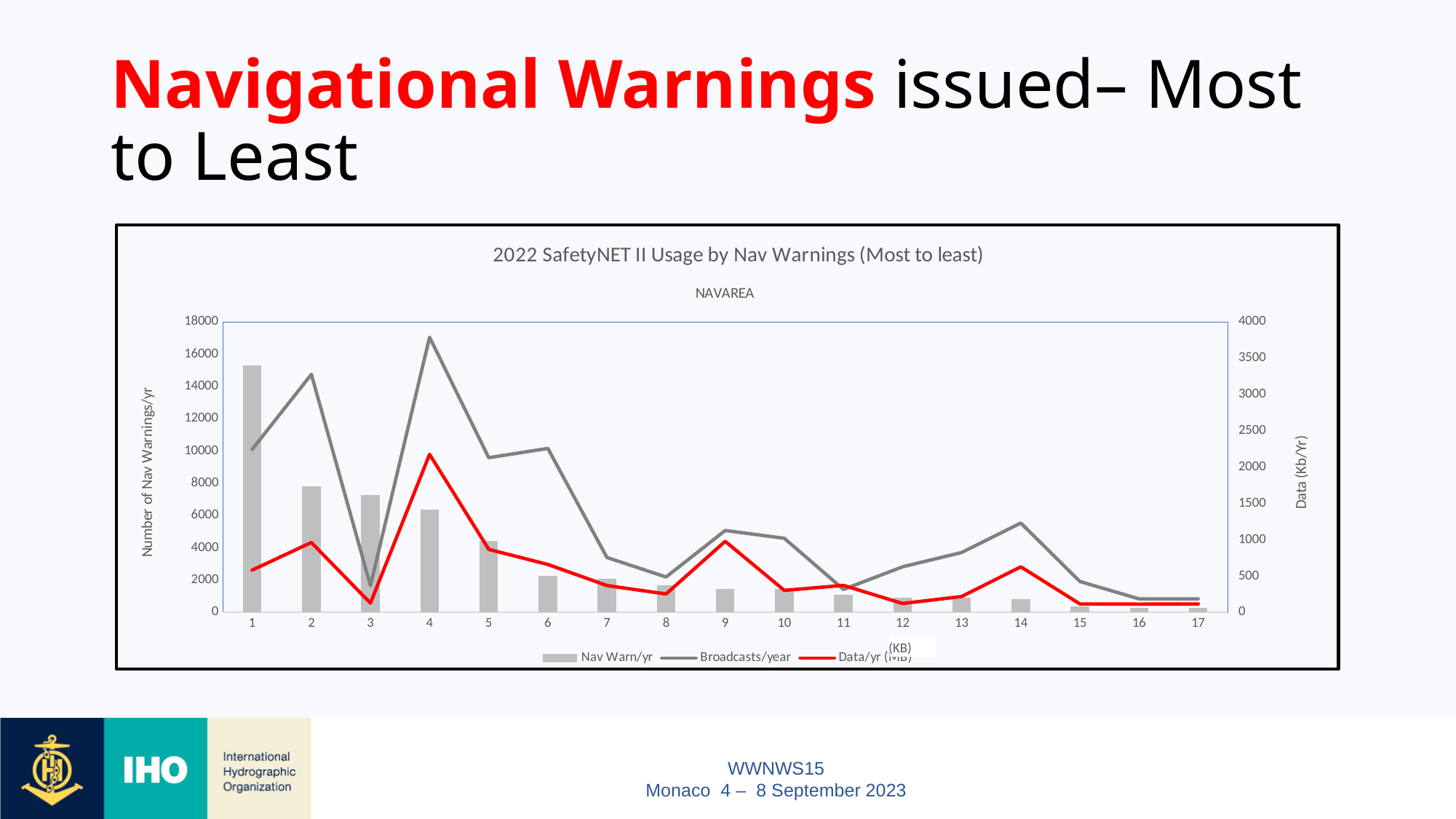
Is the Nav Warn/yr value for NAVAREA 1 greater or less than 14000? greater Do the Nav Warn/yr bars generally rise or fall from NAVAREA 1 to NAVAREA 17? fall Is the Nav Warn/yr value for NAVAREA 2 greater or less than 10000? less Which series is drawn as a red line? Data/yr Which has the larger Nav Warn/yr bar, NAVAREA 1 or NAVAREA 4? NAVAREA 1 What is the title of the chart? 2022 SafetyNET II Usage by Nav Warnings (Most to least) What kind of chart is shown on the slide? Bar and line chart How many NAVAREA categories are plotted along the x axis? 17 How many series does the legend list? 3 Is the Nav Warn/yr value for NAVAREA 3 greater or less than 6000? greater At which NAVAREA does the Broadcasts/year line reach its peak? 4 Which NAVAREA has the highest Nav Warn/yr bar? 1